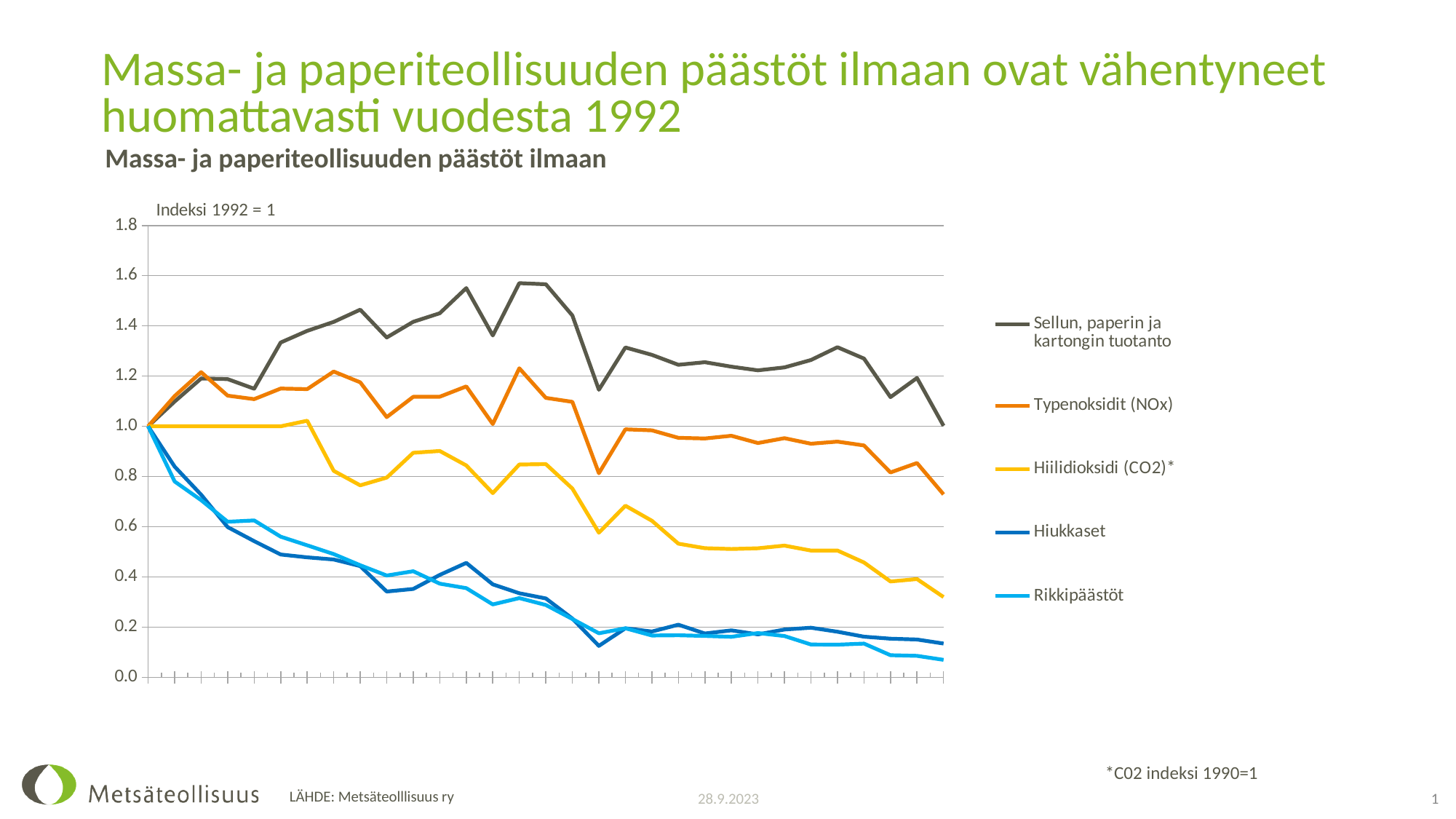
Is the final value of Rikkipäästöt greater or less than 0.2? less At the right end of the chart, which is higher: Hiukkaset or Rikkipäästöt? Hiukkaset Is the peak value of Sellun, paperin ja kartongin tuotanto greater or less than 1.4? greater Which series has the lowest value at the right end of the chart? Rikkipäästöt Do the values for Rikkipäästöt rise or fall along the x axis overall? fall What kind of chart is shown on the slide? line chart What is the chart's title? Massa- ja paperiteollisuuden päästöt ilmaan How many series does the legend list? 5 Is the final value of Hiilidioksidi (CO2)* greater or less than 0.4? less Which series reaches the highest value on the chart? Sellun, paperin ja kartongin tuotanto What index note is printed above the y axis of the chart? Indeksi 1992 = 1